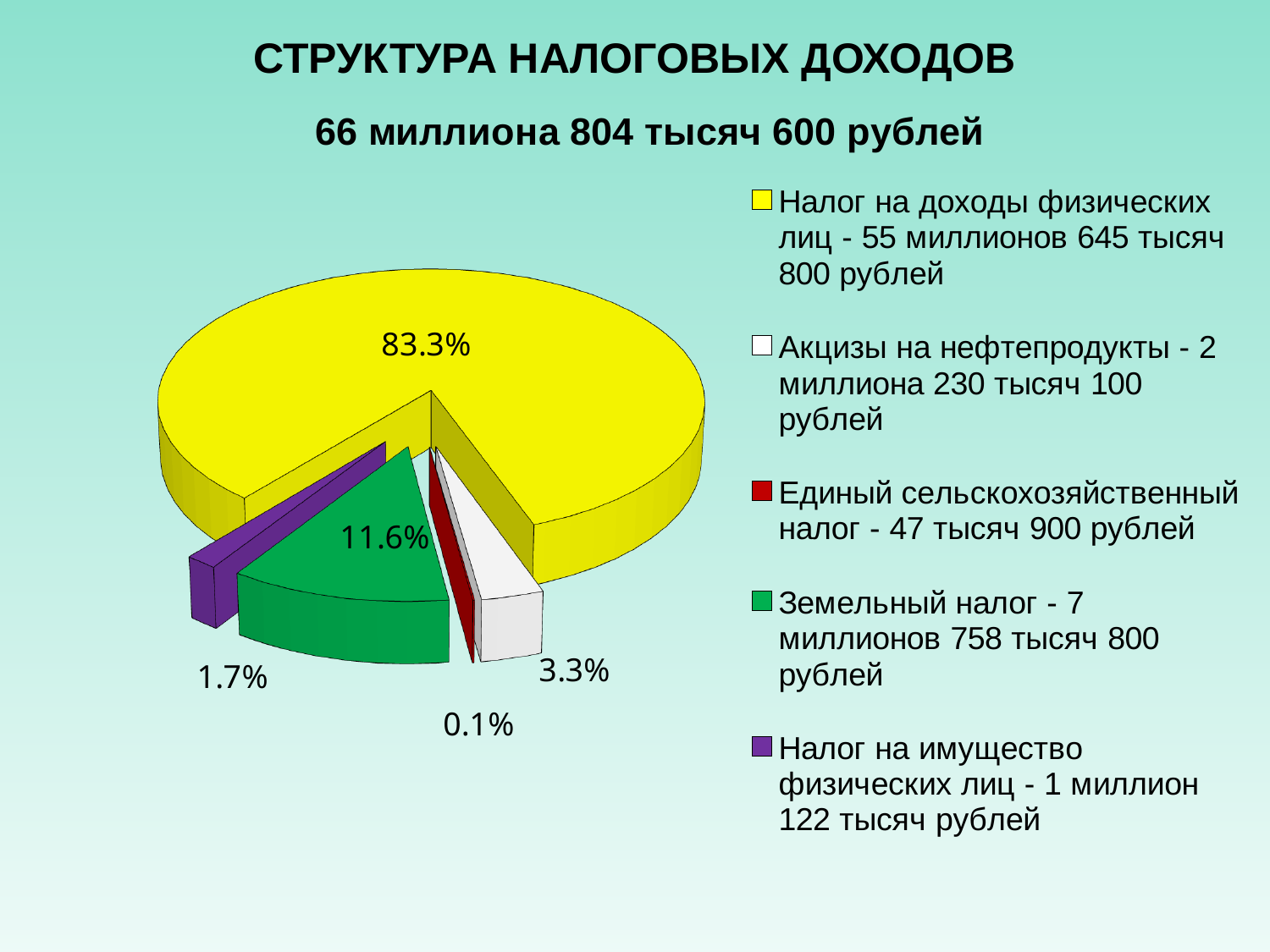
What share of the pie does "Земельный налог" (green slice) have? 11.6% How many slices does the pie chart have? 5 Which category has the largest share of the pie? Налог на доходы физических лиц Which category has the smallest share of the pie? Единый сельскохозяйственный налог What share of the pie does "Налог на имущество физических лиц" (purple slice) have? 1.7% What kind of chart is shown on the slide? pie chart What share of the pie does "Акцизы на нефтепродукты" (white slice) have? 3.3% What is the title of the chart on the slide? 66 миллиона 804 тысяч 600 рублей Which is larger: the share for "Земельный налог" or the share for "Акцизы на нефтепродукты"? Земельный налог What is the difference in percentage points between the share for "Земельный налог" and the share for "Налог на имущество физических лиц"? 9.9